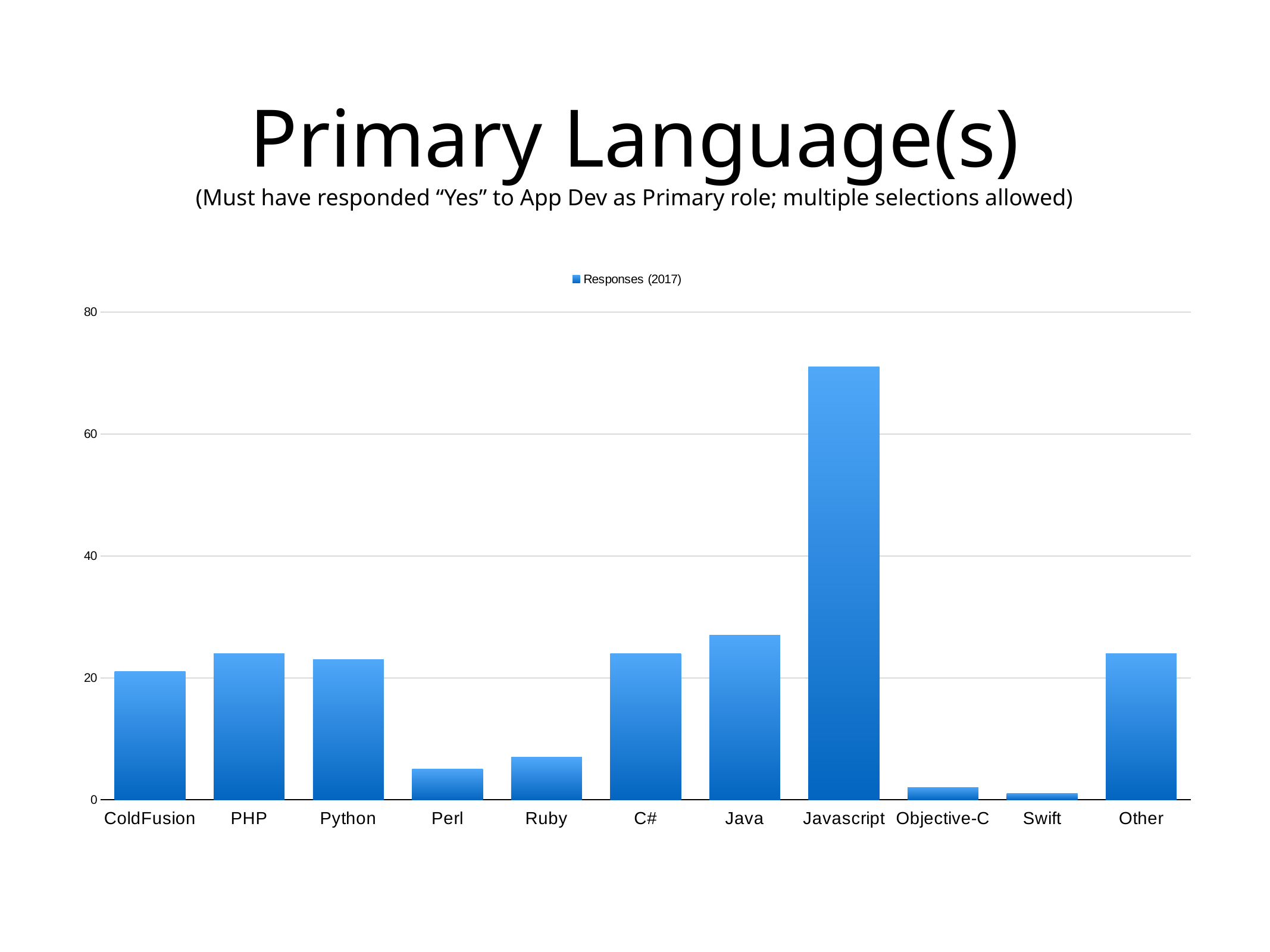
How many series does the legend list? 1 Which language has the lowest number of responses? Swift Is the value for Java greater or less than 20? greater How many language categories are shown on the x axis? 11 Which has more responses, Ruby or Perl? Ruby Is the value for Perl greater or less than 20? less Which language has the highest number of responses? Javascript Is the value for Javascript greater or less than 60? greater What kind of chart is shown on the slide? bar chart Which has more responses, Java or Perl? Java What is the series name shown in the legend? Responses (2017)